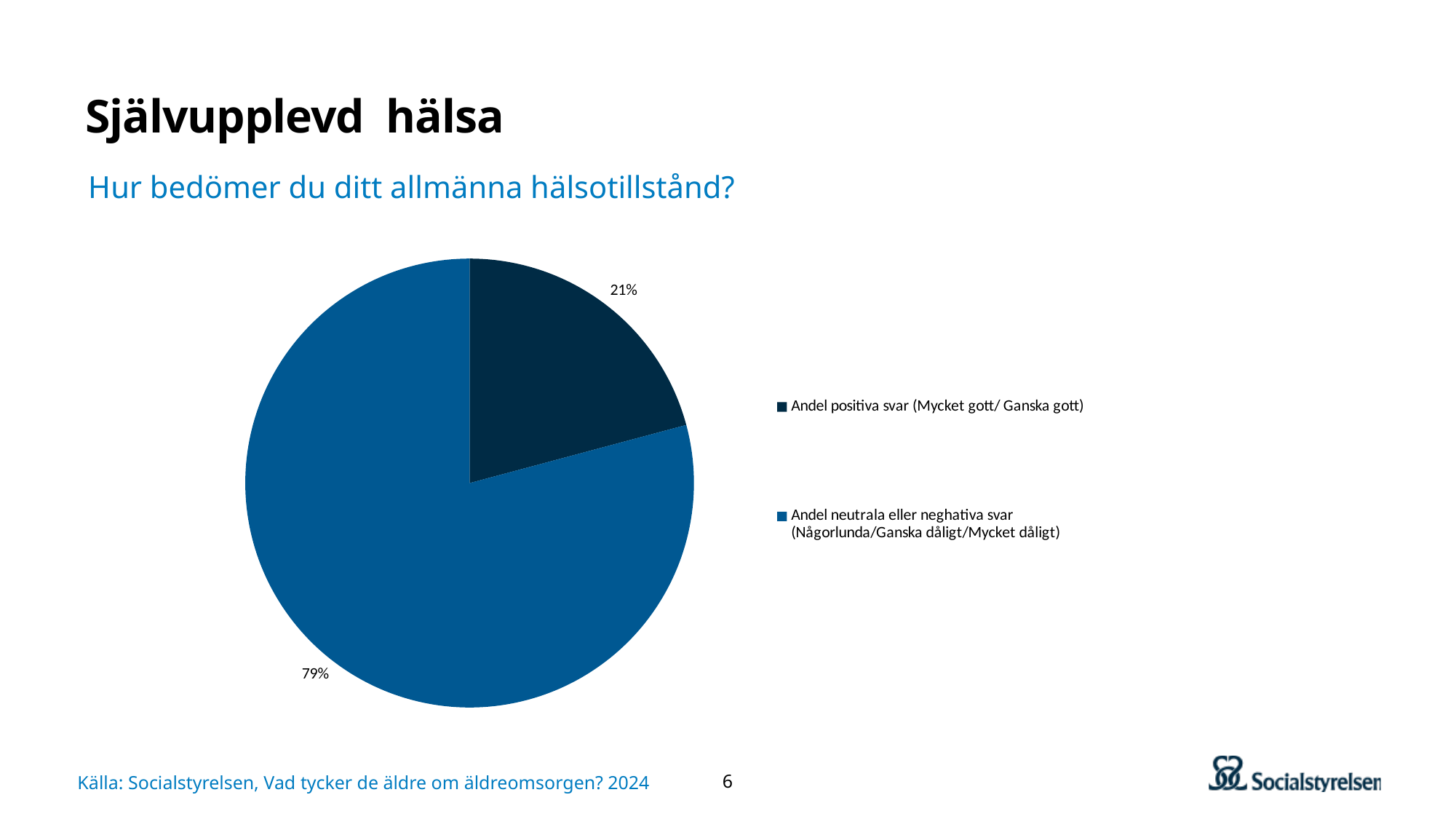
Which slice of the pie is the smallest? Andel positiva svar (Mycket gott/ Ganska gott) What is the total of the two percentages shown on the pie chart? 100% Which is larger: the slice for 'Andel positiva svar' or the slice for 'Andel neutrala eller neghativa svar'? Andel neutrala eller neghativa svar What is the difference in percentage points between the 79% slice and the 21% slice? 58 What colour is the slice for 'Andel positiva svar (Mycket gott/ Ganska gott)'? Dark navy blue How many entries does the legend list? 2 What share of the pie is labelled 'Andel neutrala eller neghativa svar (Någorlunda/Ganska dåligt/Mycket dåligt)'? 79% Which slice of the pie is the largest? Andel neutrala eller neghativa svar (Någorlunda/Ganska dåligt/Mycket dåligt) What kind of chart is shown on the slide? Pie chart What share of the pie is labelled 'Andel positiva svar (Mycket gott/ Ganska gott)'? 21% How many slices does the pie chart have? 2 What question is shown as the chart's heading? Hur bedömer du ditt allmänna hälsotillstånd?